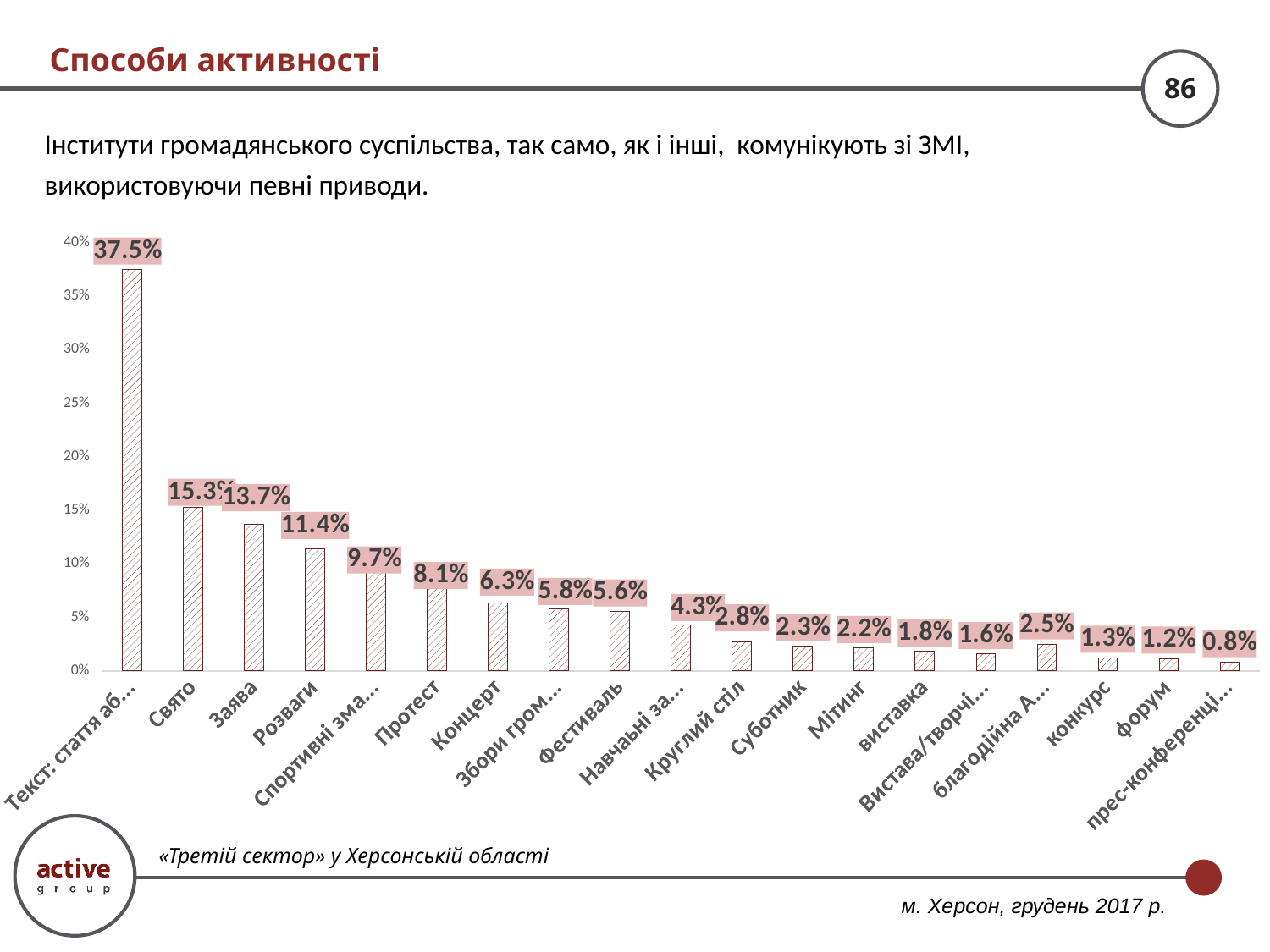
How many categories are shown in the chart? 19 Which is larger, the value for Концерт or the value for Фестиваль? Концерт What type of chart is shown on the slide? bar chart What is the value for Протест? 8.1% What is the value for форум? 1.2% What is the value for Свято? 15.3% Is the value for Свято greater or less than 10%? greater Which category has the lowest value? прес-конференці... Do the values generally rise or fall from left to right along the x axis? fall Which category has the highest value? Текст: стаття аб... What is the value for Круглий стіл? 2.8% What is the difference between the values for Заява and Розваги? 2.3%